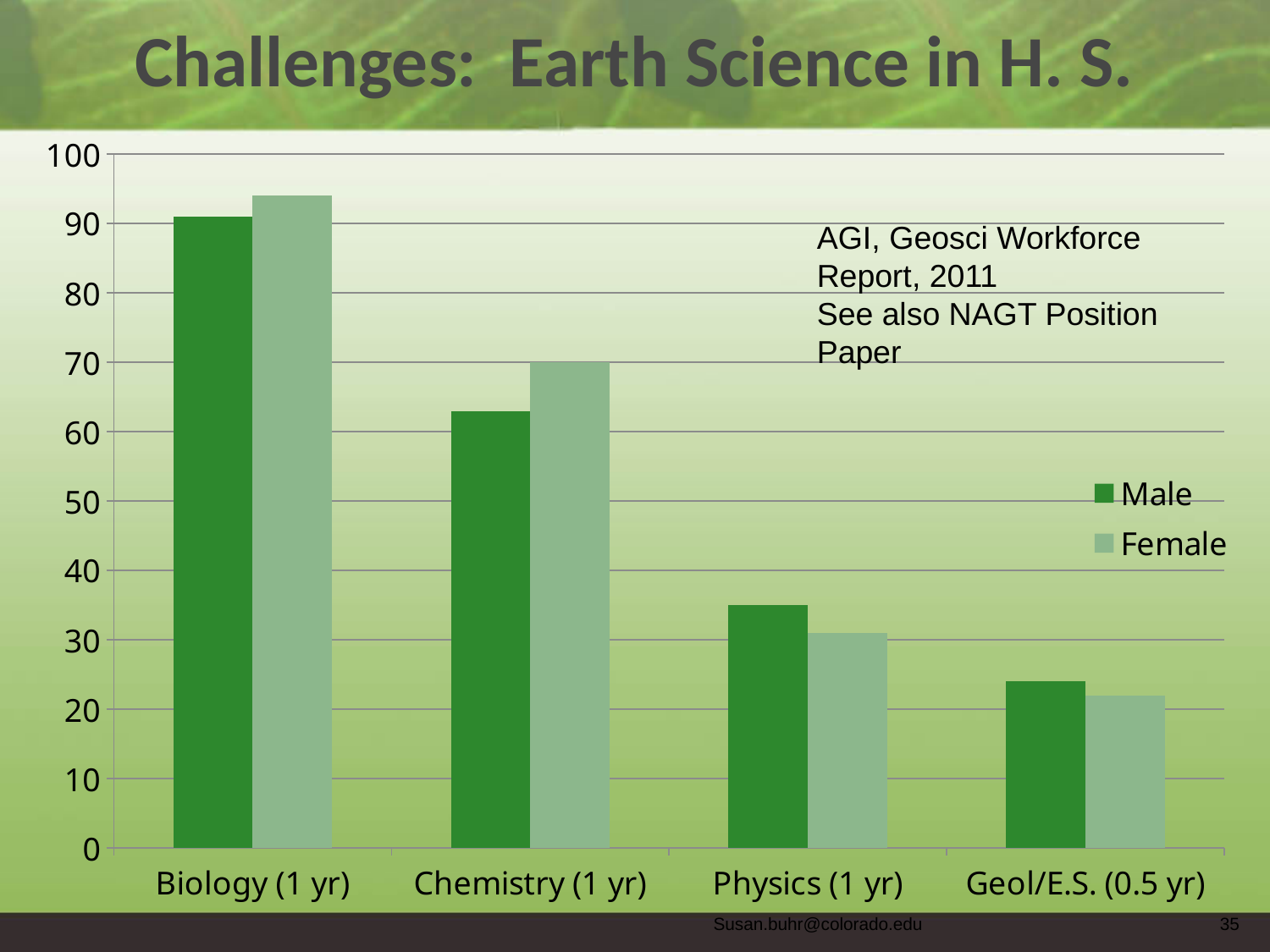
How many categories are shown on the x axis of the chart? 4 Which category has the lowest Female value? Geol/E.S. (0.5 yr) What are the two series named in the chart's legend? Male and Female For Chemistry (1 yr), which is larger, the Male or the Female value? Female Is the Male value for Chemistry (1 yr) greater or less than 50? greater Is the Male value for Geol/E.S. (0.5 yr) greater or less than 30? less Do the Male values rise or fall moving from Biology (1 yr) to Geol/E.S. (0.5 yr) along the x axis? fall How many series does the chart's legend list? 2 What kind of chart is shown on the slide? bar chart Is the Female value for Physics (1 yr) greater or less than 40? less Which category has the highest Male value? Biology (1 yr)